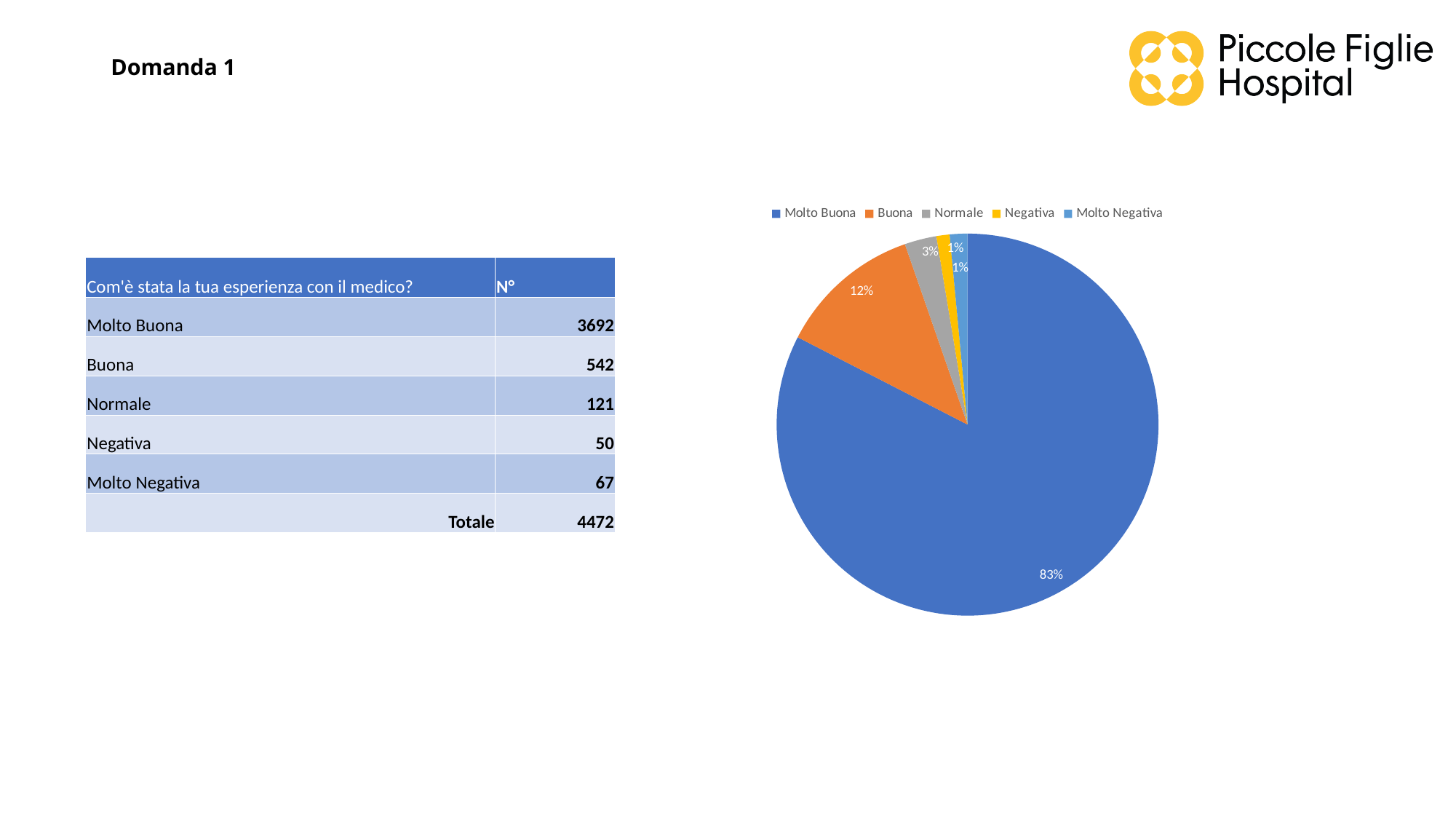
What is the difference in percentage points between the Molto Buona slice and the Buona slice? 71% How many series does the legend of the pie chart list? 5 What kind of chart is shown on the slide? pie chart How many slices does the pie chart have? 5 Which legend entry is shown in yellow? Negativa What colour is the Buona slice in the pie chart? orange What share of the pie does the Buona slice represent? 12% Which is larger in the pie chart, the Buona slice or the Normale slice? Buona Which category has the largest slice in the pie chart? Molto Buona What share of the pie does the Normale slice represent? 3% What share of the pie does the Molto Buona slice represent? 83%